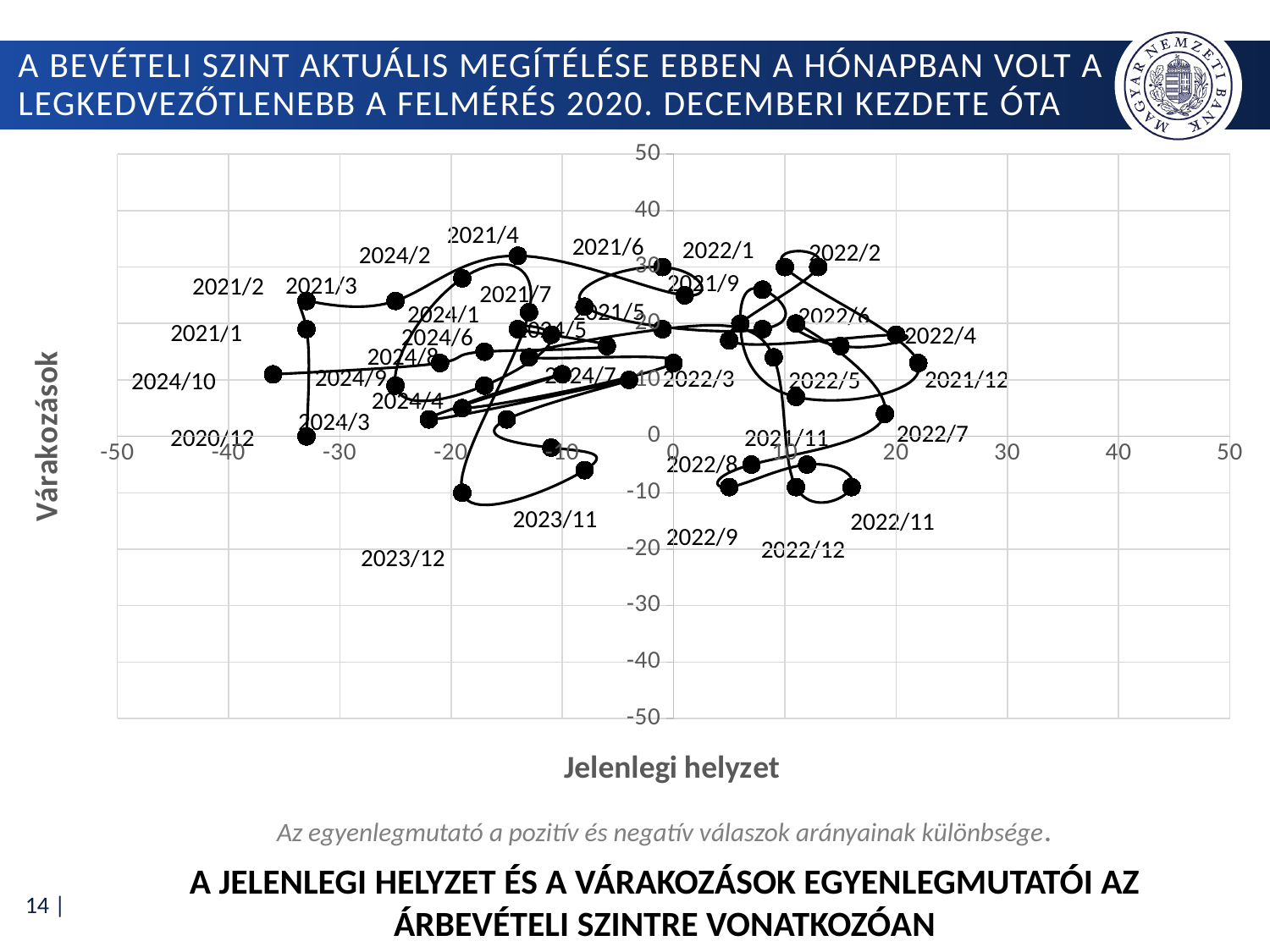
Is the vertical-axis (Várakozások) value for the point labelled 2023/11 greater or less than 0? less Is the vertical-axis (Várakozások) value for the point labelled 2021/4 greater or less than 20? greater Which point has the larger horizontal-axis (Jelenlegi helyzet) value, 2024/10 or 2022/2? 2022/2 Which point has the larger vertical-axis (Várakozások) value, 2021/4 or 2023/11? 2021/4 What is the title of the vertical axis of the chart? Várakozások What is the title of the horizontal axis of the chart? Jelenlegi helyzet Is the vertical-axis (Várakozások) value for the point labelled 2024/10 greater or less than 0? greater What kind of chart is shown on the slide? Scatter chart